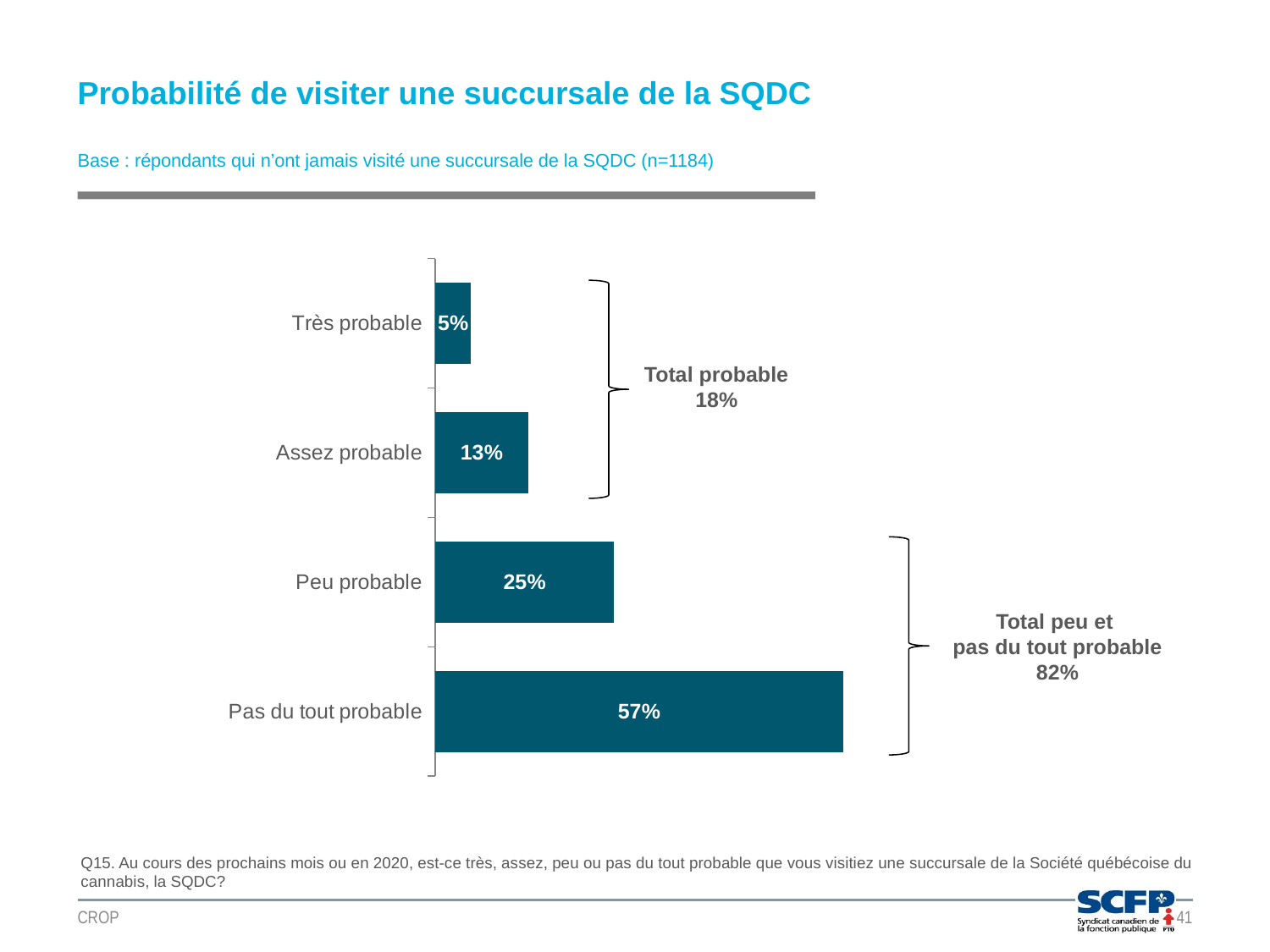
What is the value for "Peu probable"? 25% What is the value for "Pas du tout probable"? 57% What is the difference between the values for "Pas du tout probable" and "Peu probable"? 32% What is the "Total peu et pas du tout probable" value shown next to the bracket? 82% Which category has the highest value? Pas du tout probable How many categories are shown in the chart? 4 What is the value for "Très probable"? 5% What kind of chart is shown on the slide? Bar chart What is the "Total probable" value shown next to the bracket? 18% What is the value for "Assez probable"? 13% Which category has the lowest value? Très probable Which is larger, the value for "Assez probable" or the value for "Peu probable"? Peu probable